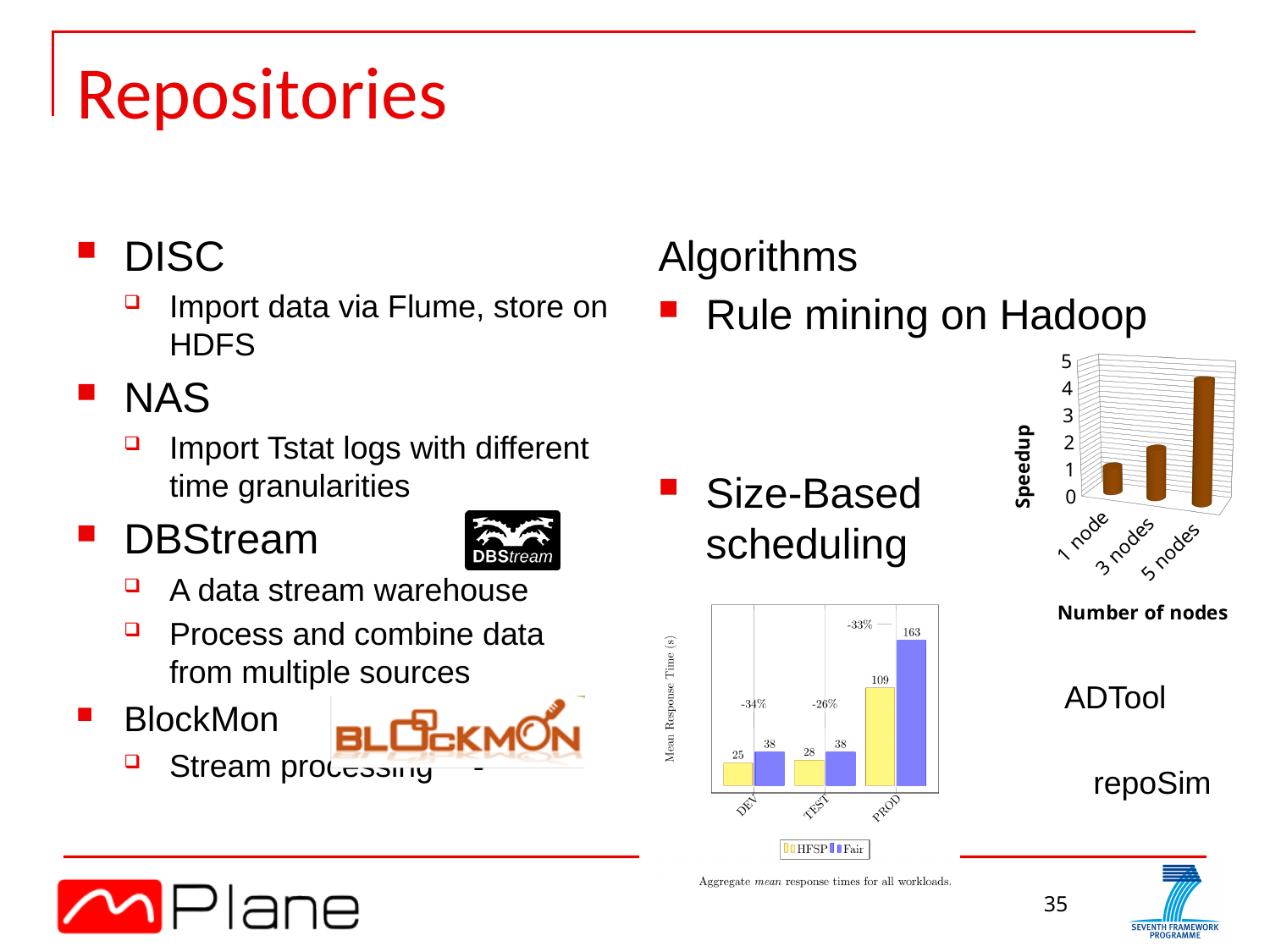
In the Mean Response Time chart, how many series does the legend list? 2 In the Mean Response Time chart, what is the HFSP value for PROD? 109 What kind of chart is the Speedup chart? bar chart In the Mean Response Time chart, which workload has the highest Fair value? PROD In the Mean Response Time chart, how many workload categories are shown on the x axis? 3 In the Speedup chart, is the value for 5 nodes greater or less than 3? greater In the Mean Response Time chart, what is the Fair value for PROD? 163 In the Mean Response Time chart, what is the difference between the Fair and HFSP values for PROD? 54 In the Mean Response Time chart, which workload has the lowest HFSP value? DEV In the Mean Response Time chart, what is the HFSP value for DEV? 25 In the Speedup chart, which number of nodes gives the highest speedup? 5 nodes In the Mean Response Time chart, what is the difference between the Fair and HFSP values for TEST? 10